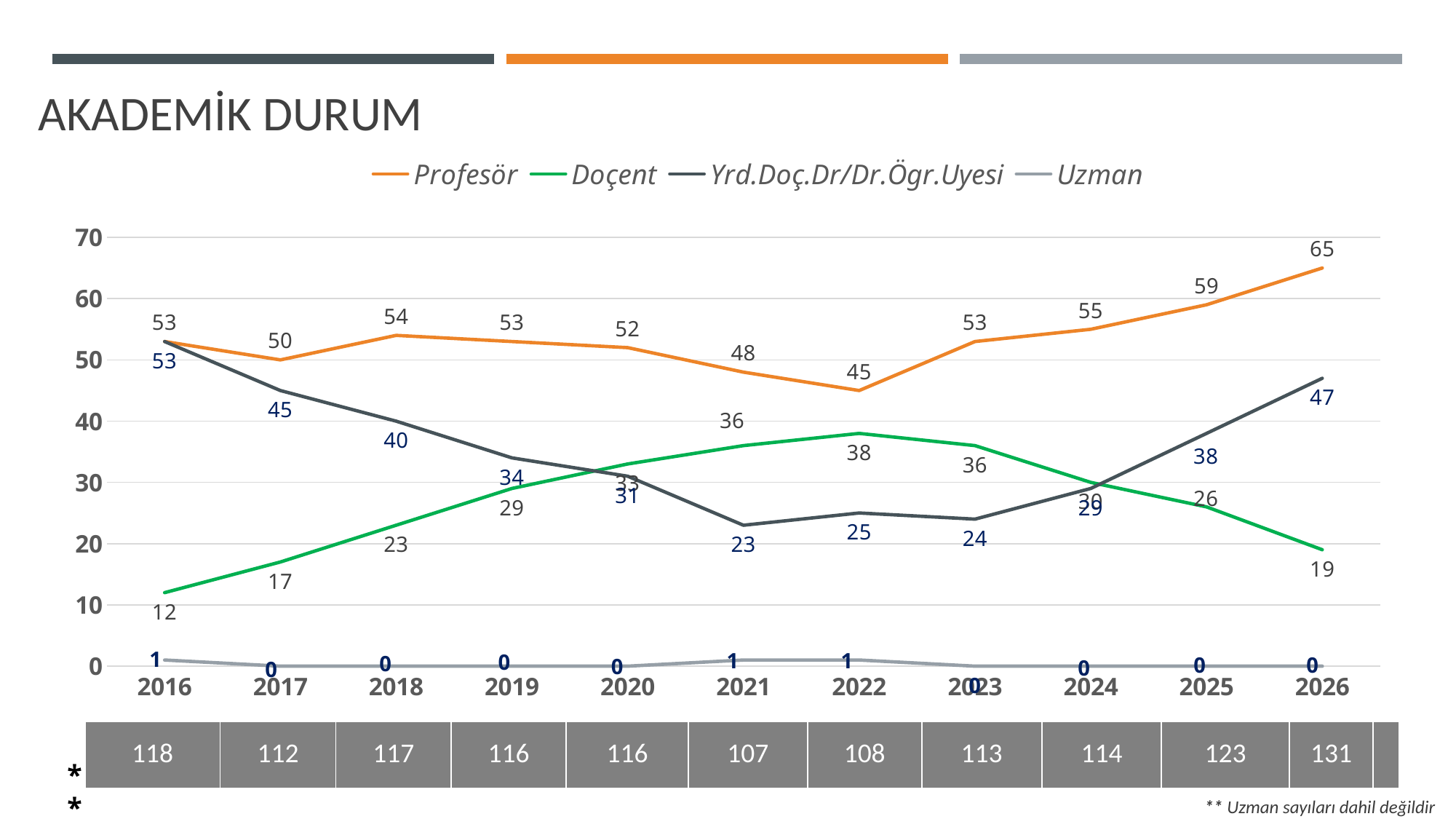
What is the value for Doçent in 2016? 12 What is the difference between the Profesör value and the Doçent value in 2026? 46 How many series does the legend list? 4 What kind of chart is shown on the slide? Line chart What is the value for Profesör in 2026? 65 Does the Yrd.Doç.Dr/Dr.Ögr.Uyesi series rise or fall from 2016 to 2021? Fall In which year does the Profesör series reach its highest value? 2026 In which year does the Profesör series reach its lowest value? 2022 What is the value for Yrd.Doç.Dr/Dr.Ögr.Uyesi in 2021? 23 In which year does the Doçent series reach its highest value? 2022 Which is larger in 2024: the Doçent value or the Yrd.Doç.Dr/Dr.Ögr.Uyesi value? Doçent How many years are shown on the x axis? 11